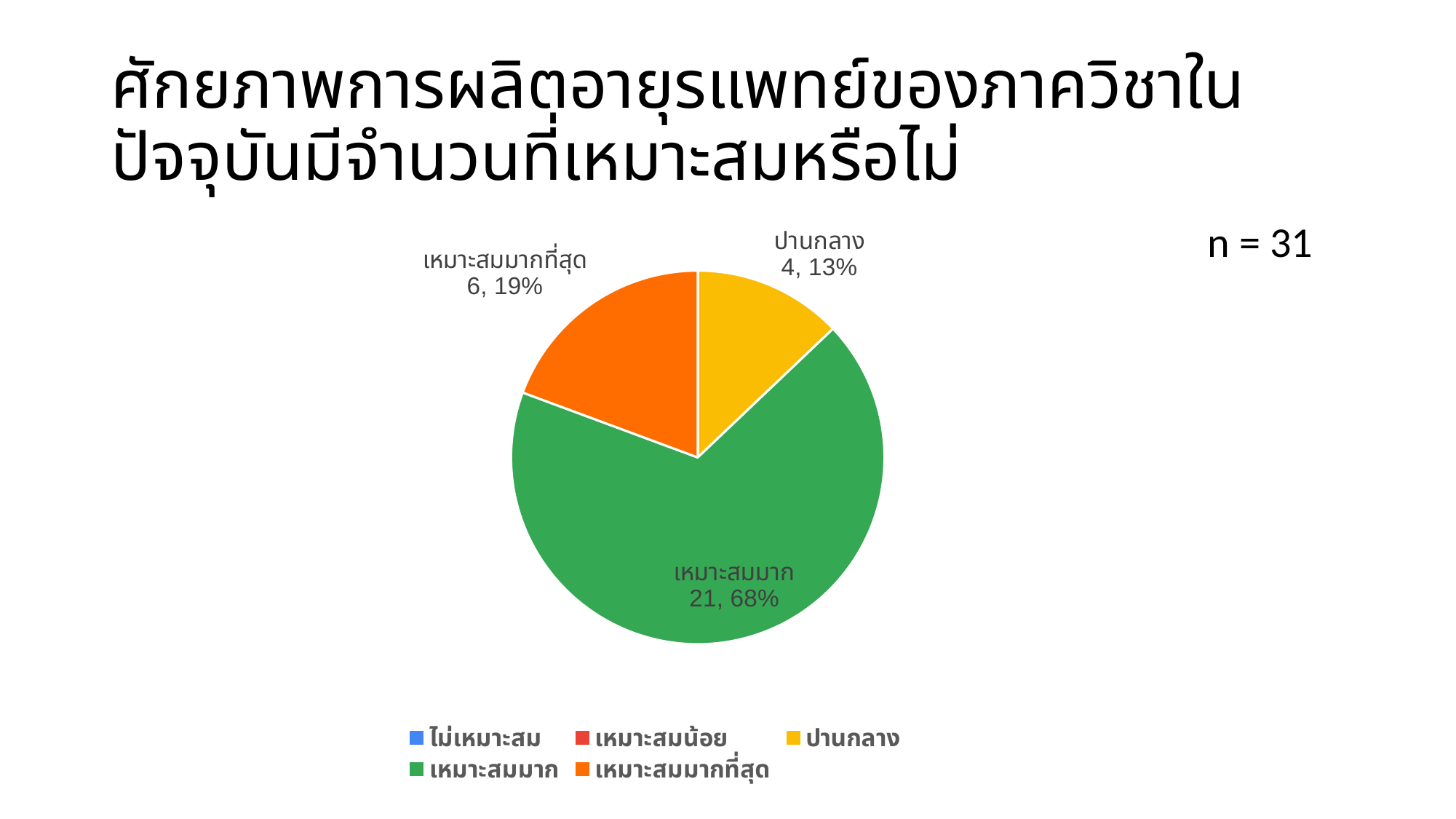
What percentage of the pie is the เหมาะสมมากที่สุด slice? 19% What is the difference in count between เหมาะสมมาก and เหมาะสมมากที่สุด? 15 Which category has the largest slice of the pie? เหมาะสมมาก How many categories does the legend list? 5 Which is larger, the count for เหมาะสมมากที่สุด or the count for ปานกลาง? เหมาะสมมากที่สุด How many respondents chose เหมาะสมมาก? 21 What percentage of the pie is the ปานกลาง slice? 13% What is the value of n shown on the slide? 31 What colour is the เหมาะสมมาก slice? Green What kind of chart is shown on the slide? Pie chart Among the slices with labels shown, which category has the smallest slice? ปานกลาง How many respondents chose ปานกลาง? 4